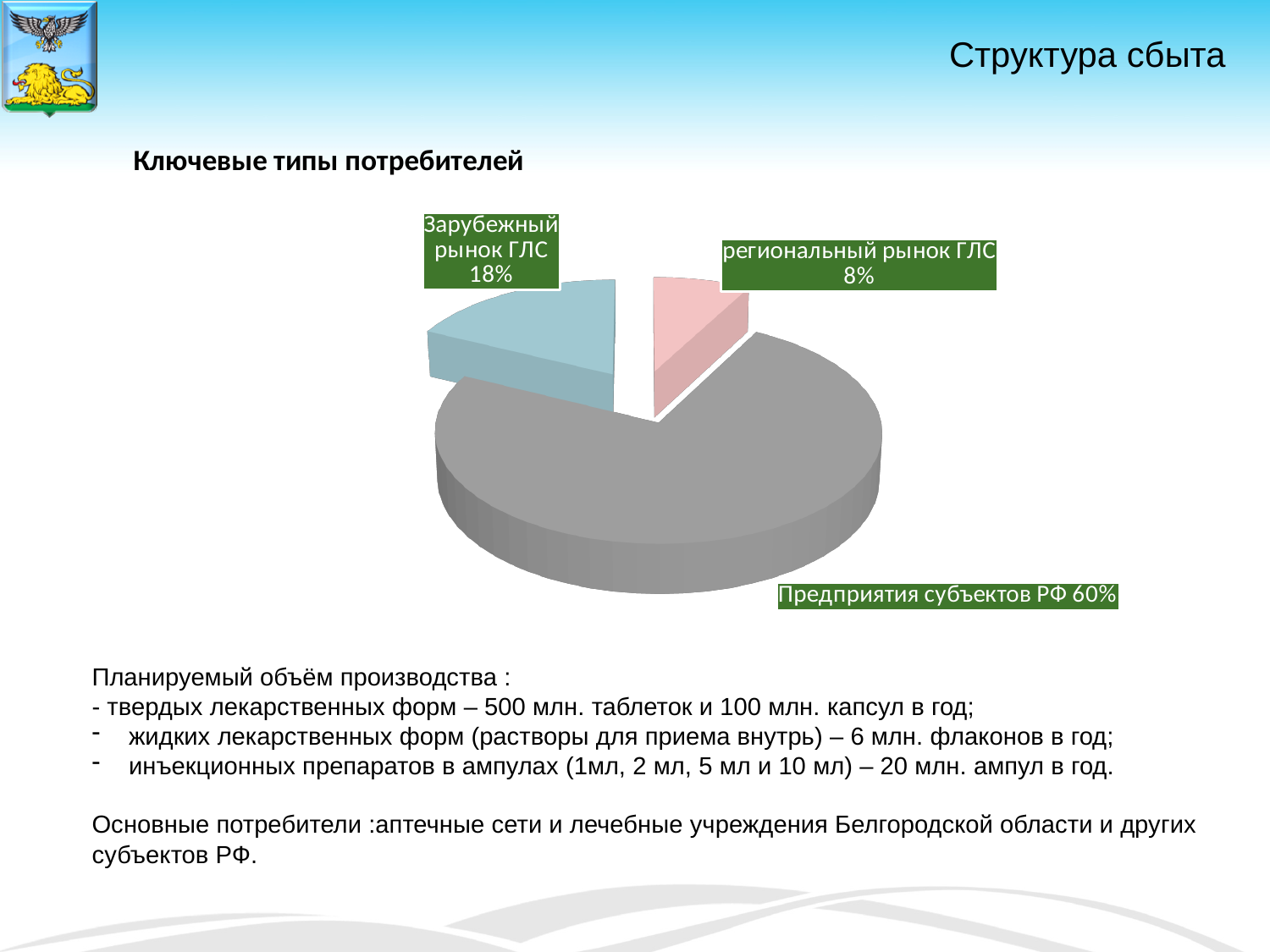
Which slice of the pie chart is the smallest? региональный рынок ГЛС How many slices does the pie chart have? 3 Which slice of the pie chart is the largest? Предприятия субъектов РФ What is the difference in percentage points between "Зарубежный рынок ГЛС" and "региональный рынок ГЛС"? 10 What colour is the "Предприятия субъектов РФ" slice of the pie chart? grey What share of the pie chart is labelled "Зарубежный рынок ГЛС"? 18% What share of the pie chart is labelled "Предприятия субъектов РФ"? 60% What is the difference in percentage points between "Предприятия субъектов РФ" and "Зарубежный рынок ГЛС"? 42 What kind of chart is shown on the slide? pie chart What share of the pie chart is labelled "региональный рынок ГЛС"? 8% What is the heading printed above the pie chart? Ключевые типы потребителей Which is larger in the pie chart: "Зарубежный рынок ГЛС" or "региональный рынок ГЛС"? Зарубежный рынок ГЛС